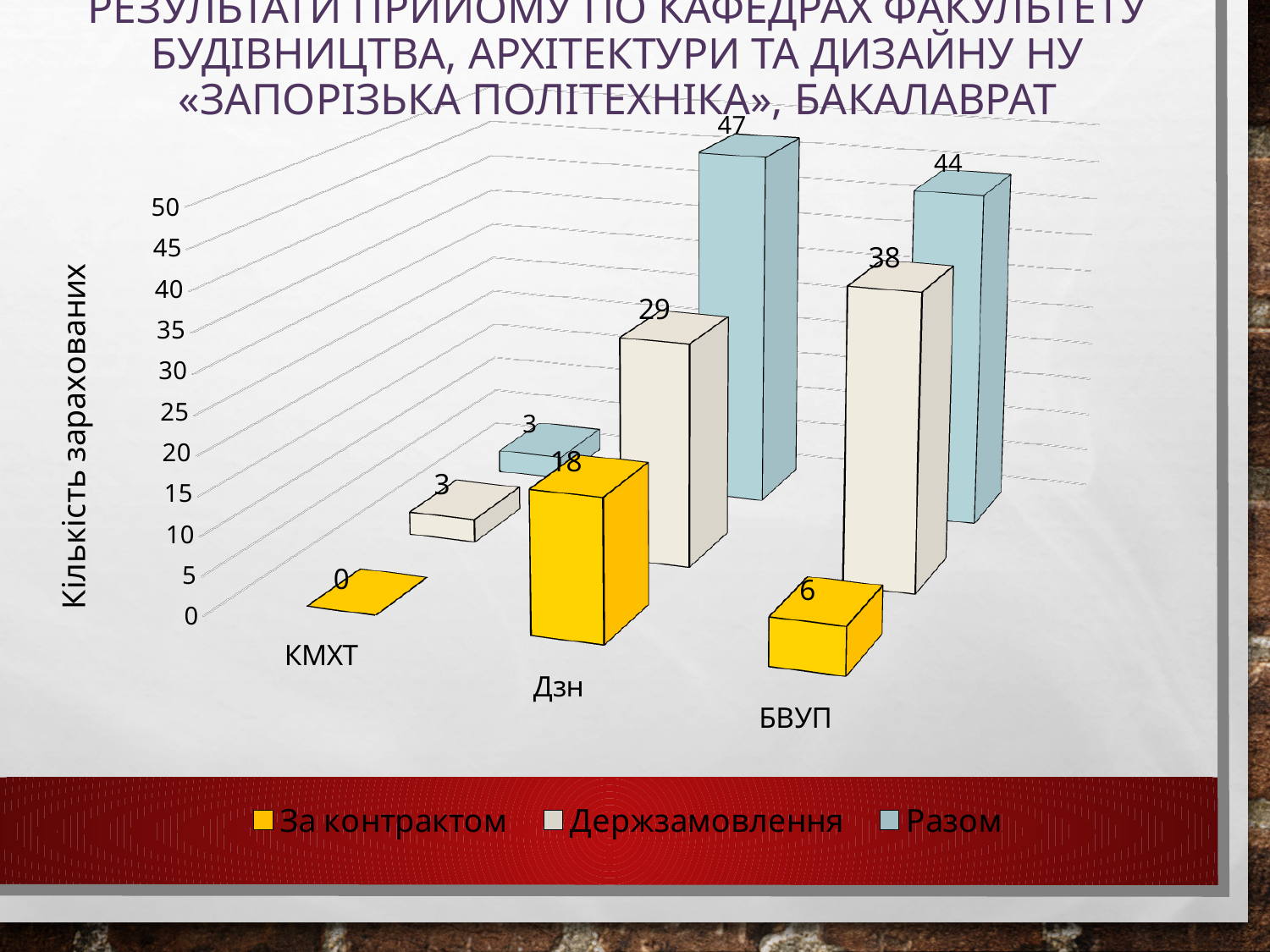
What is the difference between the Разом values for Дзн and БВУП? 3 What is the label of the vertical axis? Кількість зарахованих How many categories are shown on the x axis? 3 How many series does the legend list? 3 What is the value of За контрактом for Дзн? 18 What kind of chart is shown on the slide? Bar chart Which is larger: Держзамовлення for Дзн or Держзамовлення for БВУП? Держзамовлення for БВУП Which category has the lowest Держзамовлення value? КМХТ What is the value of Разом for КМХТ? 3 What is the value of За контрактом for КМХТ? 0 What is the value of Держзамовлення for БВУП? 38 Which category has the highest Разом value? Дзн